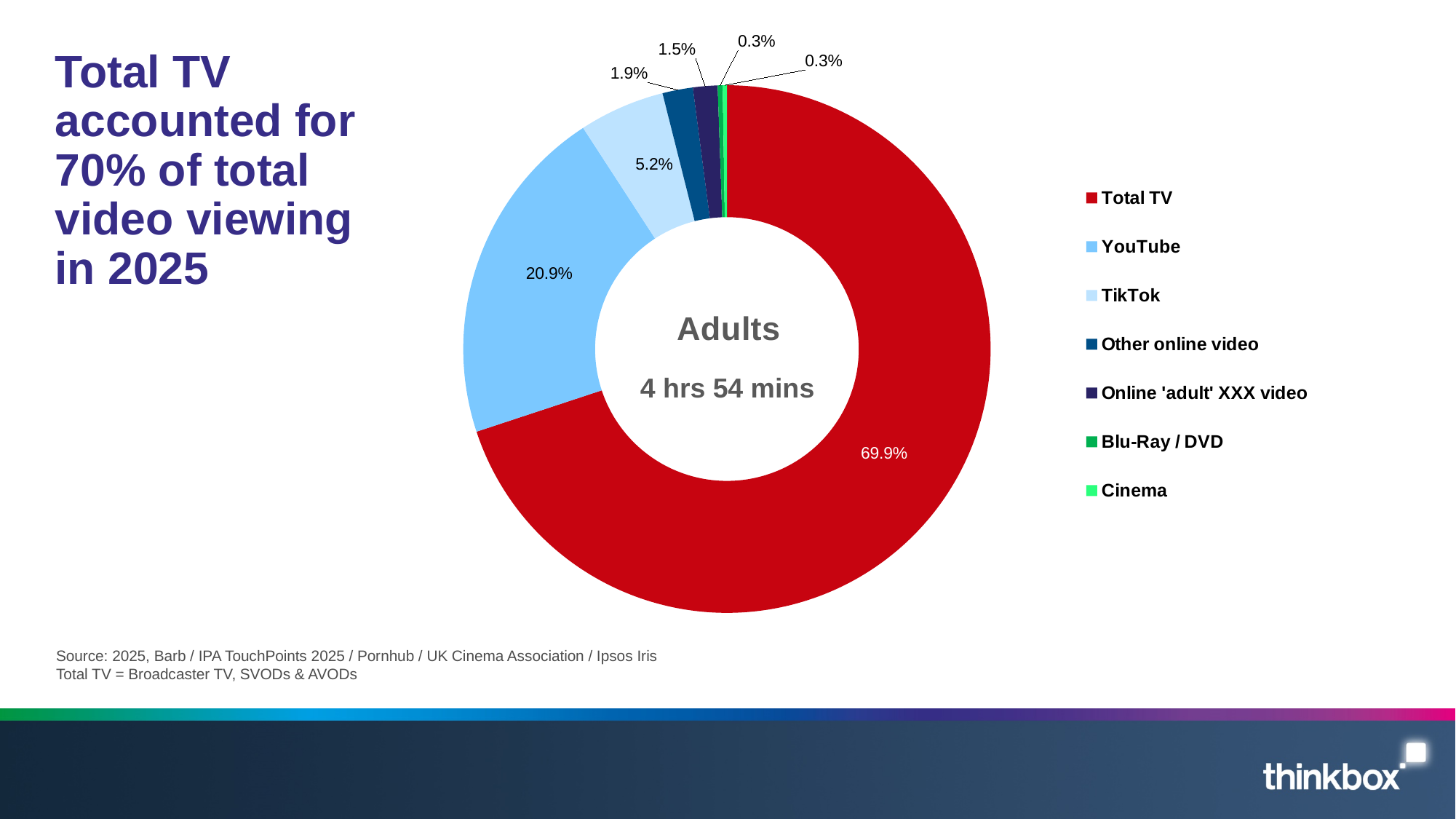
What share of total video viewing does Other online video account for? 1.9% How many categories does the legend list? 7 What kind of chart is shown on the slide? Donut (pie) chart What text appears in the centre of the donut chart? Adults 4 hrs 54 mins What share of total video viewing does YouTube account for? 20.9% What share of total video viewing does TikTok account for? 5.2% Which category has the largest share of total video viewing? Total TV What colour is the Total TV segment of the chart? Red What is the difference in share between Total TV and YouTube? 49.0 percentage points What share of total video viewing does Total TV account for? 69.9% What share of total video viewing does Online 'adult' XXX video account for? 1.5% Which has a larger share, TikTok or Other online video? TikTok